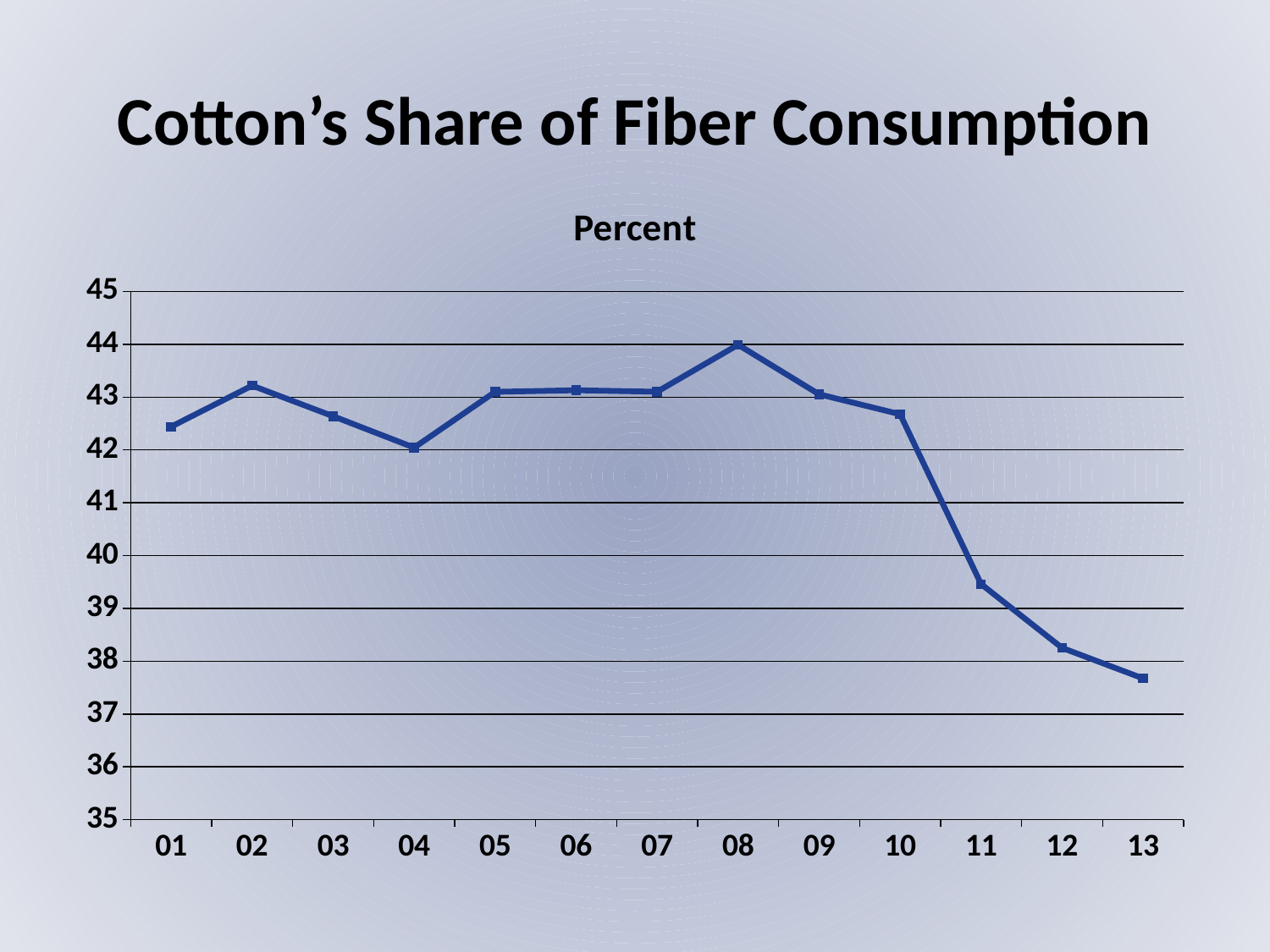
Is the value for 11 greater or less than 40? less Do the values rise or fall from 10 to 13? fall How many years are plotted along the x axis? 13 In which year is cotton's share of fiber consumption highest? 08 What is the title of the chart on the slide? Cotton's Share of Fiber Consumption What unit label appears above the chart's plot area? Percent Is the value for 08 greater or less than 43? greater Is the value for 13 greater or less than 38? less In which year is cotton's share of fiber consumption lowest? 13 What kind of chart is shown on the slide? line chart Which year has the larger value, 02 or 04? 02